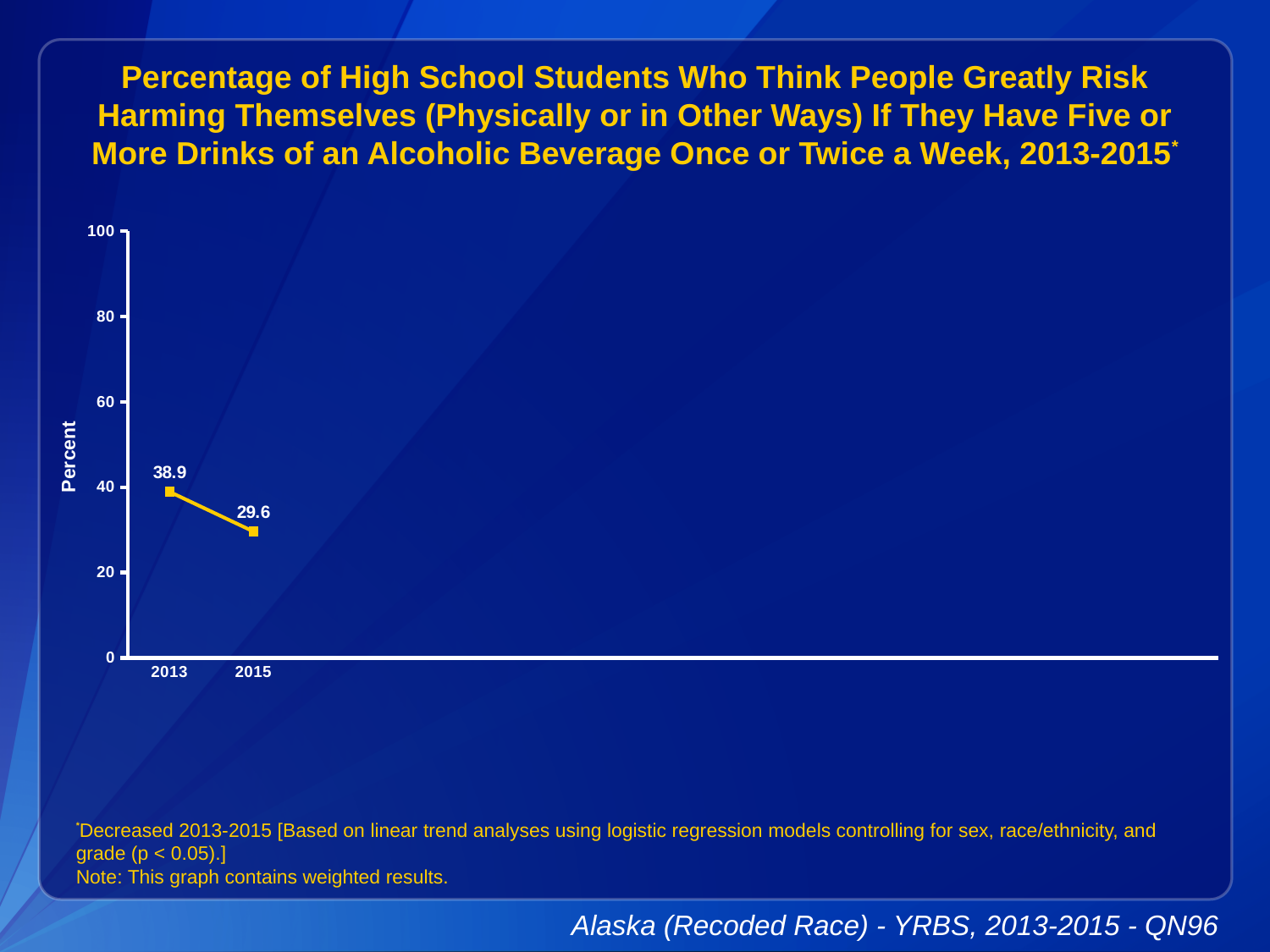
Is the value for 2015 greater or less than 40? less How many data points are plotted on the chart? 2 Which is larger, the value for 2013 or the value for 2015? 2013 What is the label of the y axis? Percent Which year has the lowest value? 2015 Do the values rise or fall from 2013 to 2015? fall What is the difference between the 2013 and 2015 values? 9.3 What is the maximum value shown on the y axis? 100 What is the value for 2015? 29.6 Which year has the highest value? 2013 What is the value for 2013? 38.9 What kind of chart is shown on the slide? line chart